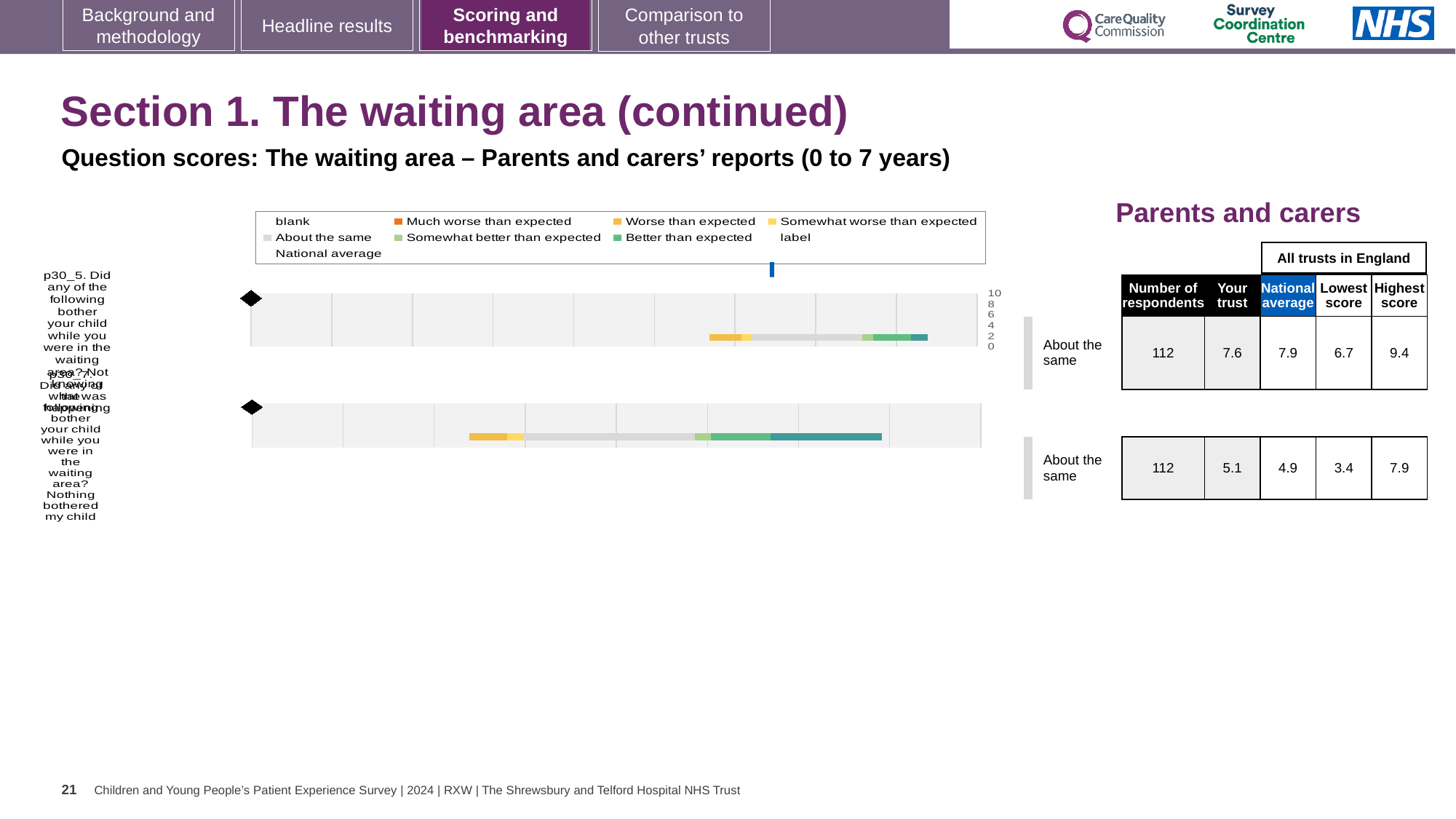
How many respondents are listed for the bottom chart? 112 For the bottom chart, what is the 'Your trust' score? 5.1 What benchmark category is shown next to the bottom chart? About the same For the bottom chart, which is larger: the 'Your trust' score or the national average? Your trust How many question charts are shown on the slide? 2 For the top chart, what is the difference between the highest score and the lowest score? 2.7 For the bottom chart, what is the lowest score among all trusts in England? 3.4 For the top chart, what is the national average score? 7.9 For the top chart, which is larger: the 'Your trust' score or the national average? National average What kind of chart is used for the top question on the slide? bar chart For the top chart, what is the 'Your trust' score shown in the table? 7.6 For the top chart, what is the highest score among all trusts in England? 9.4